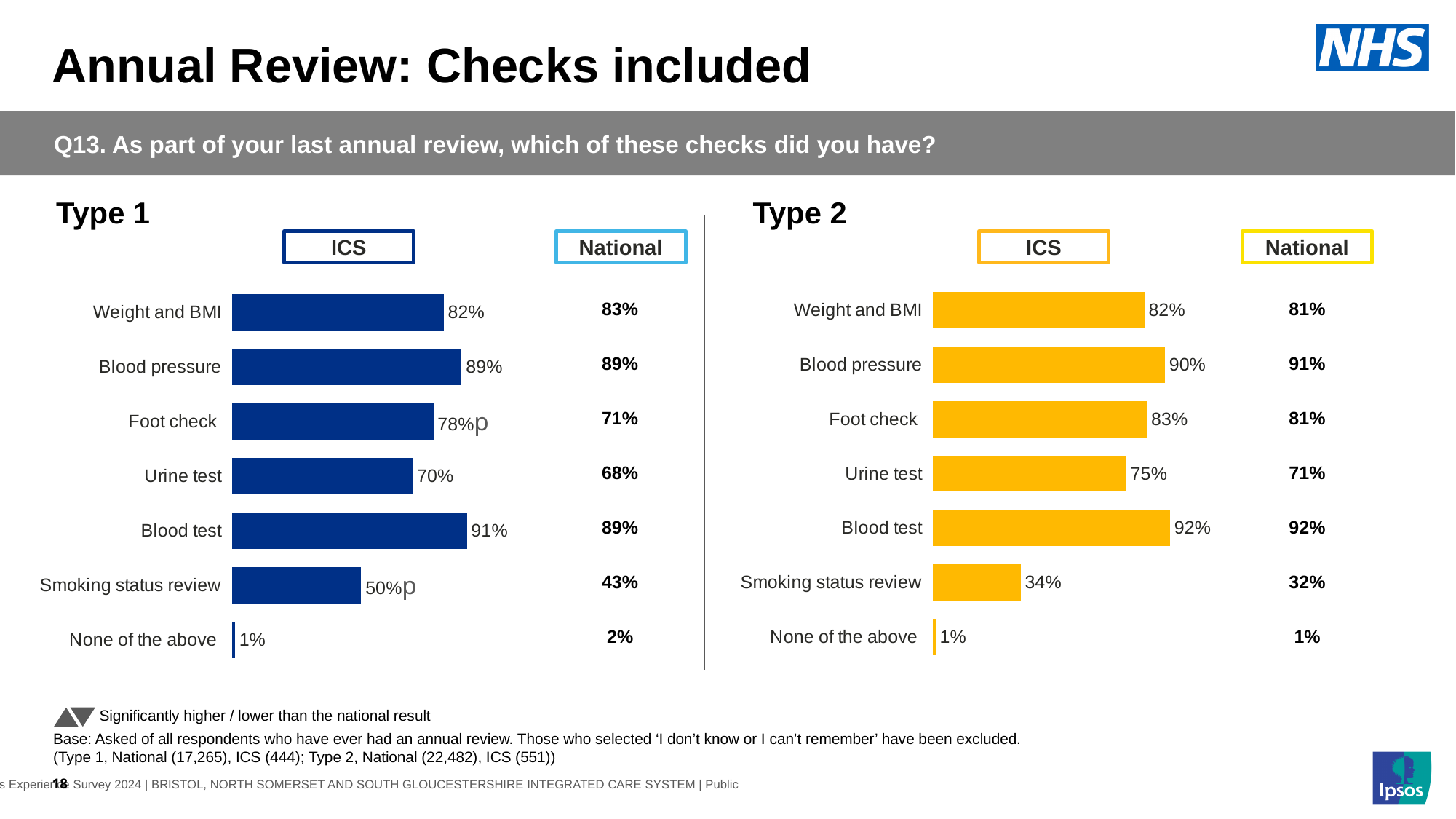
In the Type 2 chart, what is the ICS value for Smoking status review? 34% In the Type 1 chart, what is the National value for Urine test? 68% How many categories are shown in the Type 2 chart? 7 In the Type 1 chart, is the ICS value for Foot check higher or lower than the National value? higher In the Type 1 chart, what is the ICS value for Foot check? 78% In the Type 2 chart, which category has the lowest ICS value? None of the above In the Type 1 chart, what is the difference between the ICS and National values for Smoking status review? 7 percentage points In the Type 2 chart, what is the National value for Blood pressure? 91% What colour are the bars in the Type 2 chart? yellow In the Type 2 chart, what is the difference between the ICS values for Blood test and Urine test? 17 percentage points In the Type 1 chart, which check has the highest ICS value? Blood test What type of chart is used for the Type 1 ICS results? bar chart